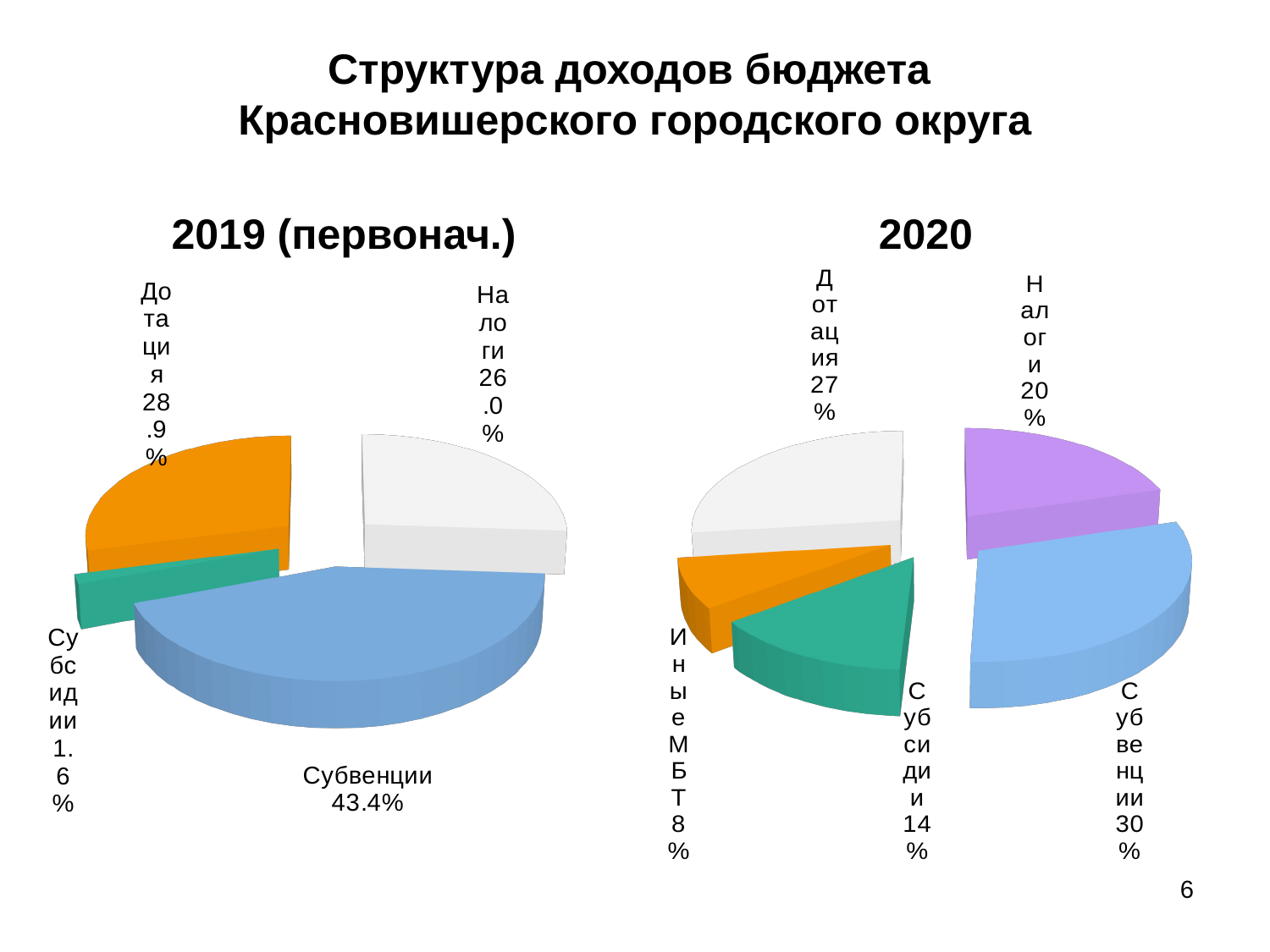
In the 2019 (первонач.) chart, which category has the smallest share? Субсидии In the 2020 chart, which category has the largest share? Субвенции In the 2020 chart, what share do Иные МБТ have? 8% How many categories does the 2020 chart show? 5 What is the title of the slide? Структура доходов бюджета Красновишерского городского округа In the 2020 chart, which is larger, Дотация or Налоги? Дотация In the 2020 chart, what share do Субвенции have? 30% What type of chart is the 2019 (первонач.) chart? Pie chart In the 2019 (первонач.) chart, what share do Налоги have? 26.0% In the 2019 (первонач.) chart, what share do Субвенции have? 43.4% In the 2019 (первонач.) chart, which category has the largest share? Субвенции In the 2019 (первонач.) chart, what is the difference between the shares of Дотация and Налоги? 2.9%